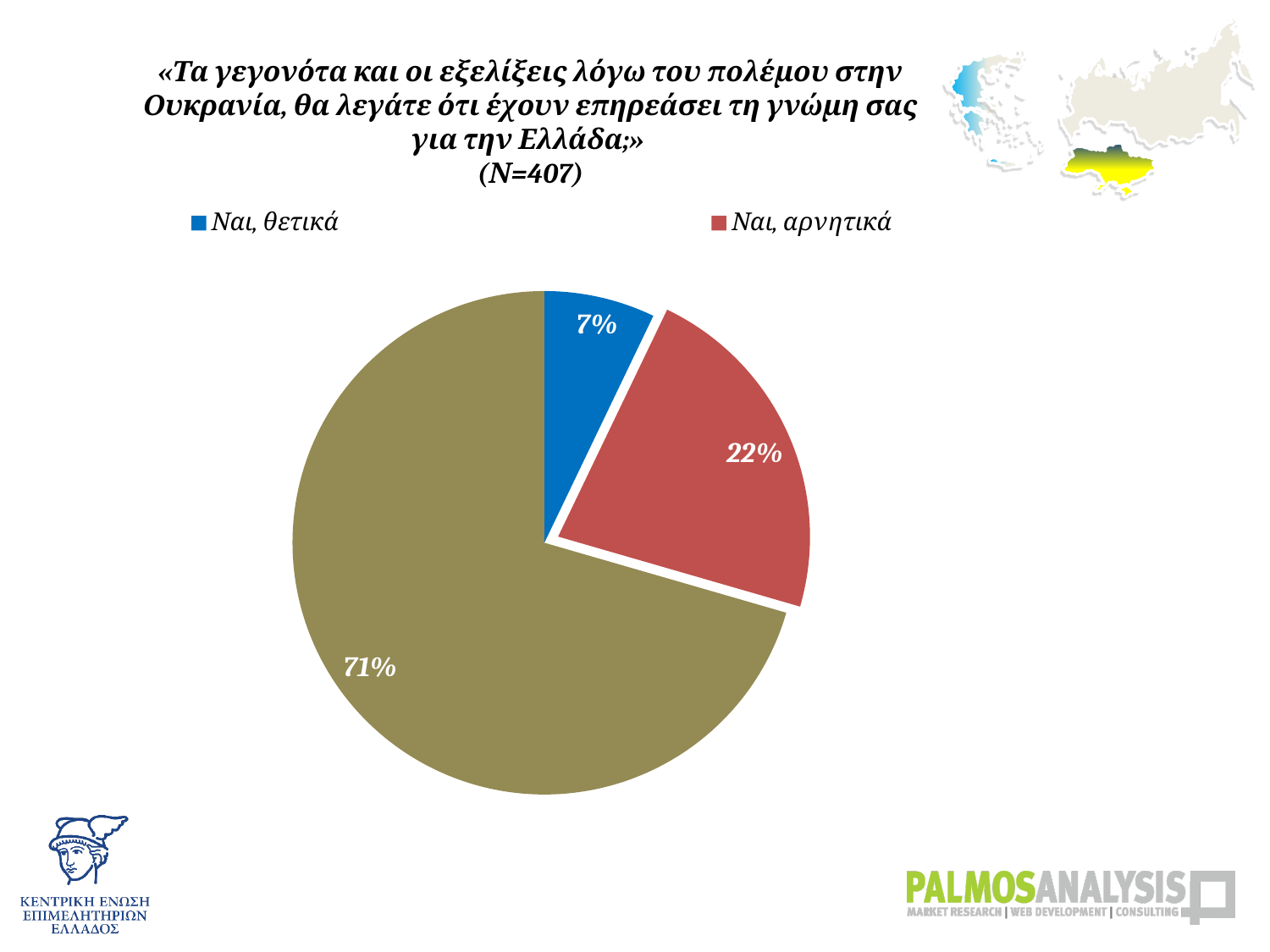
What sample size (N) is stated in the chart title? N=407 What is the value shown on the largest slice of the pie chart? 71% What is the difference in percentage points between "Ναι, αρνητικά" and "Ναι, θετικά"? 15 What kind of chart is shown on the slide? pie chart How many slices does the pie chart have? 3 What is the difference in percentage points between the largest slice and the "Ναι, αρνητικά" slice? 49 Which of the two legend categories has the smaller share, "Ναι, θετικά" or "Ναι, αρνητικά"? Ναι, θετικά What percentage of respondents answered "Ναι, αρνητικά"? 22% How many entries does the legend list? 2 What colour is the "Ναι, θετικά" slice? blue Which is larger, the share for "Ναι, αρνητικά" or the share for "Ναι, θετικά"? Ναι, αρνητικά What percentage of respondents answered "Ναι, θετικά"? 7%